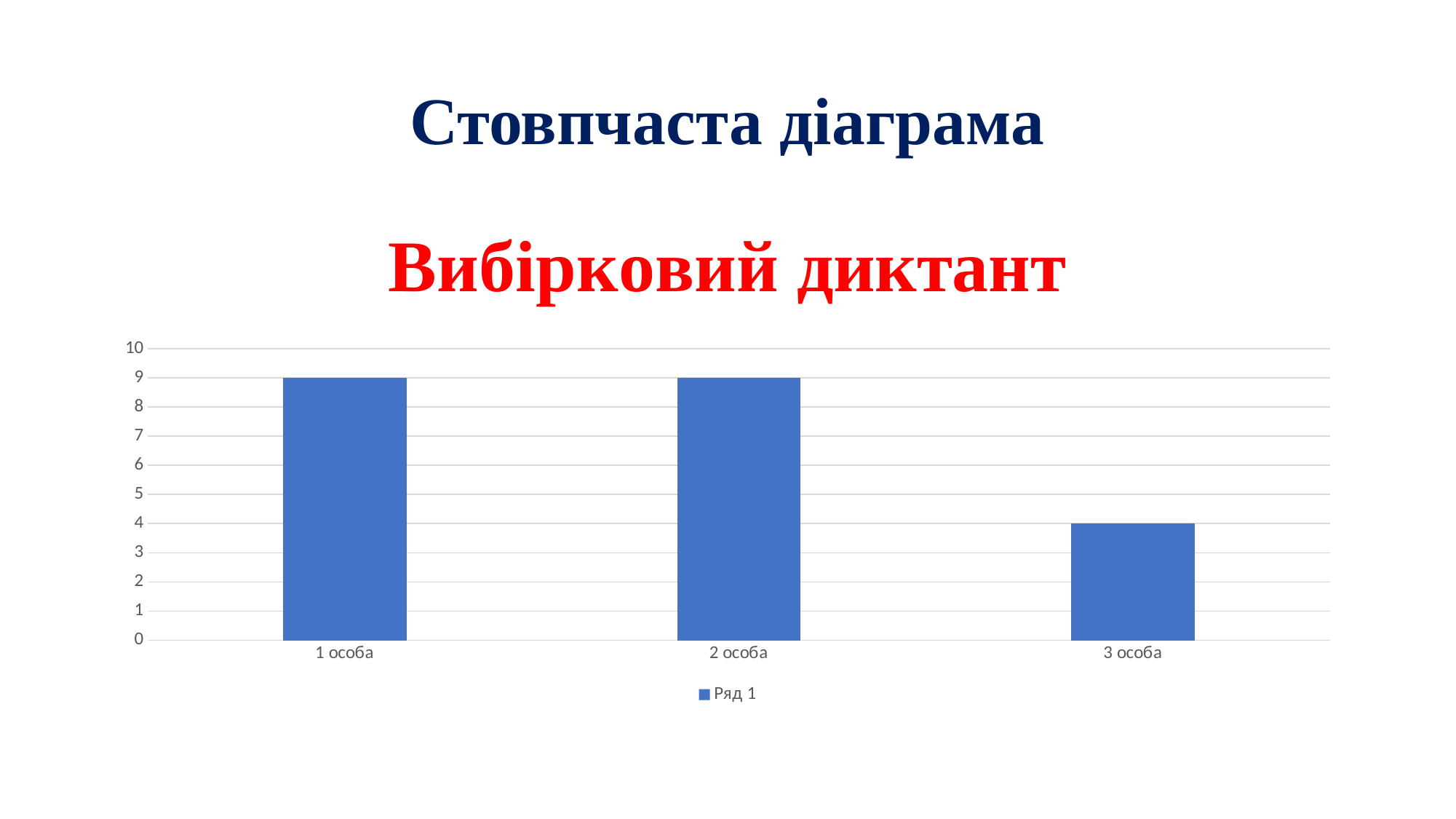
How many series does the legend list? 1 How many categories are shown on the x axis? 3 What is the value for 3 особа? 4 What is the value for 1 особа? 9 What is the value for 2 особа? 9 Which is larger, the value for 2 особа or the value for 3 особа? 2 особа What is the difference between the values for 1 особа and 3 особа? 5 What kind of chart is shown on the slide? bar chart Is the value for 1 особа greater or less than 8? greater Is the value for 3 особа greater or less than 5? less Which category has the lowest value? 3 особа What is the difference between the values for 2 особа and 3 особа? 5